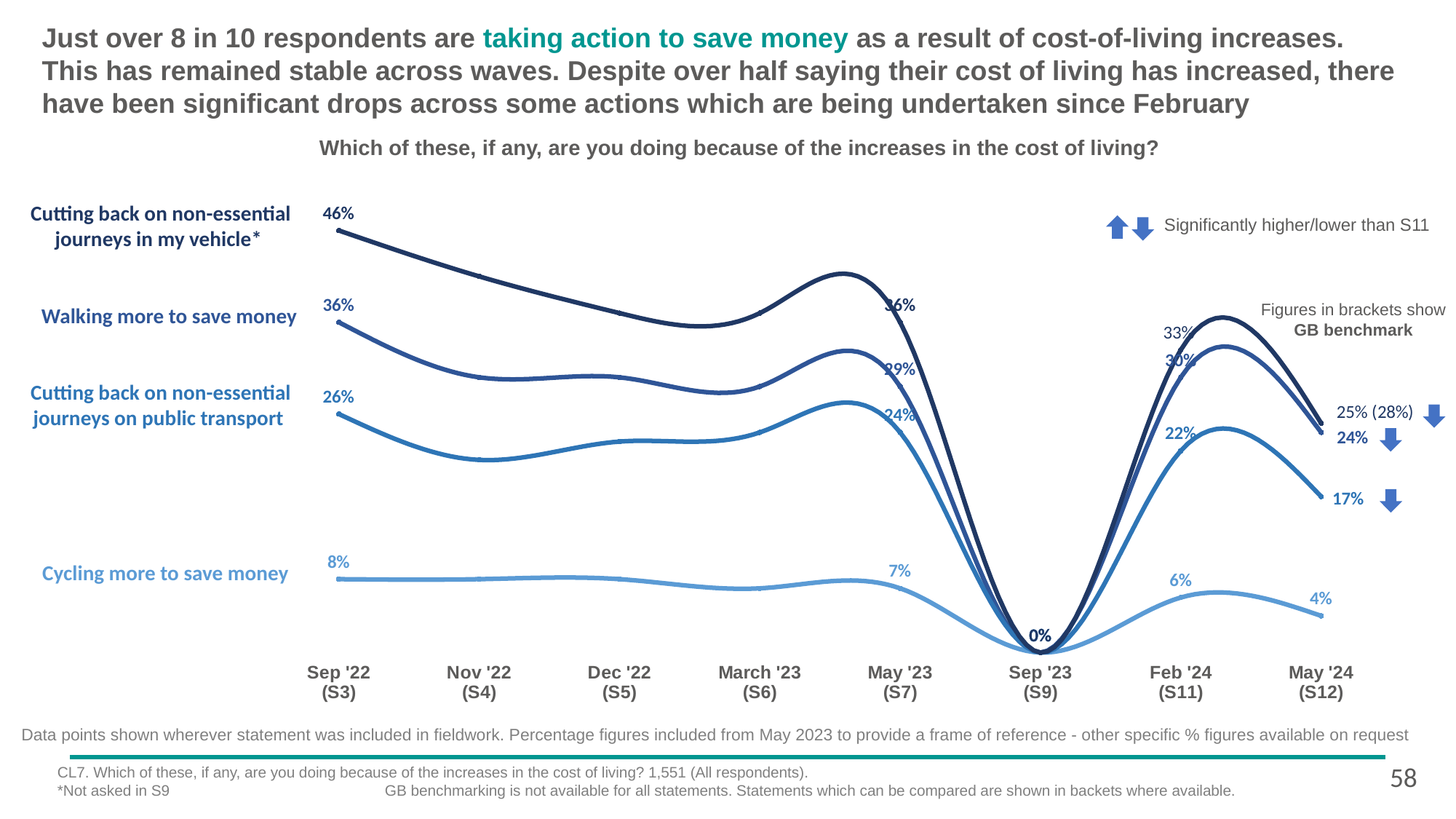
By how many percentage points did 'Cutting back on non-essential journeys in my vehicle' fall between Sep '22 (S3) and May '24 (S12)? 21 percentage points What percentage of respondents said they were cutting back on non-essential journeys in their vehicle in Sep '22 (S3)? 46% Which statement had the highest value in Sep '22 (S3)? Cutting back on non-essential journeys in my vehicle How many survey waves are shown along the x axis of the chart? 8 How many statements (lines) are plotted on the chart? 4 What kind of chart is shown on the slide? Line chart What is the value for 'Walking more to save money' in May '24 (S12)? 24% In May '24 (S12), which is higher: 'Walking more to save money' or 'Cutting back on non-essential journeys on public transport'? Walking more to save money What GB benchmark figure is shown in brackets for 'Cutting back on non-essential journeys in my vehicle' in May '24 (S12)? 28% Which statement had the lowest value in May '24 (S12)? Cycling more to save money What is the value for 'Cutting back on non-essential journeys on public transport' in May '24 (S12)? 17% What is the value for 'Cycling more to save money' in May '24 (S12)? 4%